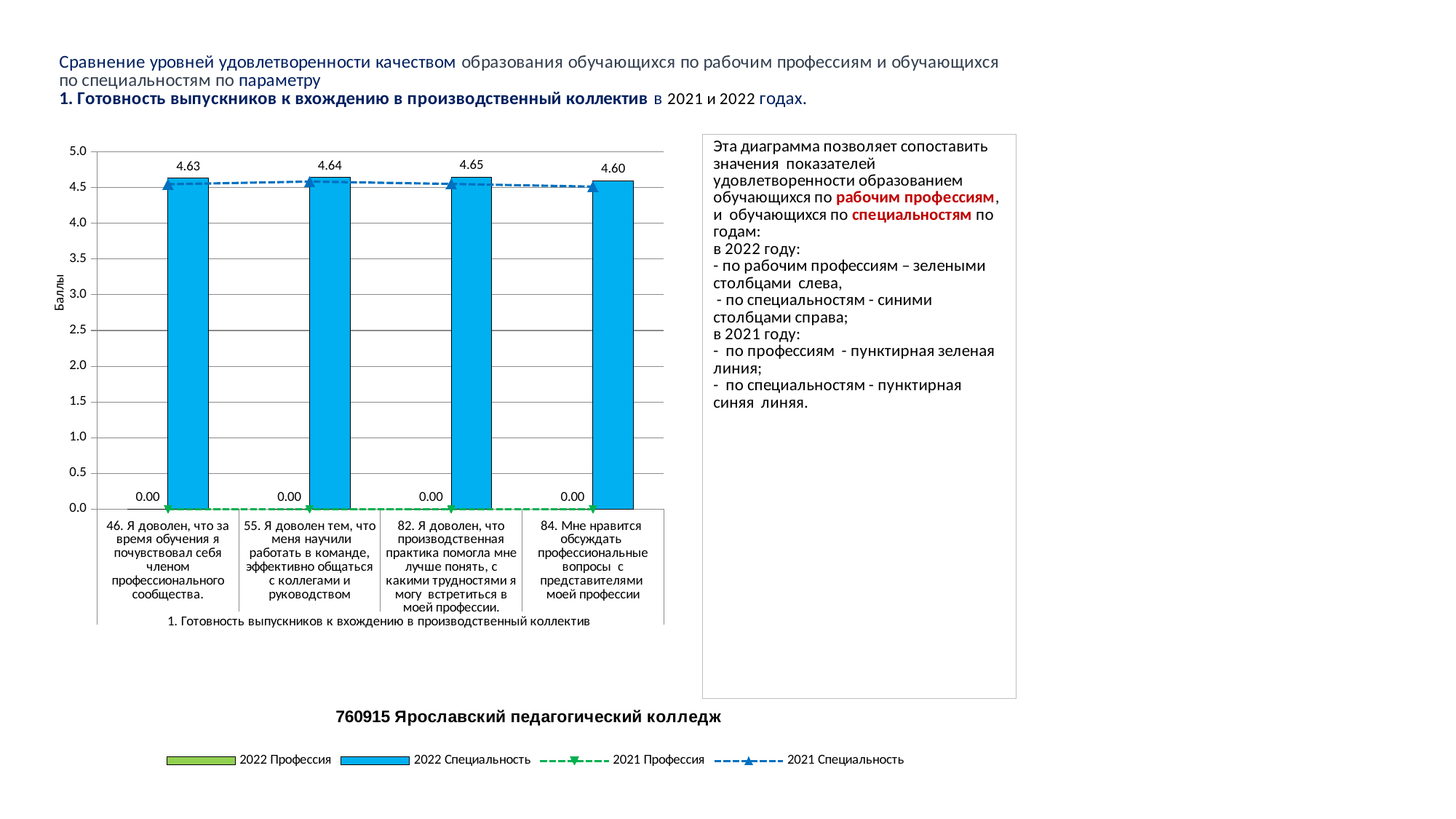
What is the value of the 2022 Специальность bar for item 46 (Я доволен, что за время обучения я почувствовал себя членом профессионального сообщества)? 4.63 Which item has the lowest 2022 Специальность value? 84. Мне нравится обсуждать профессиональные вопросы с представителями моей профессии What type of chart is used to show the 2022 values? Bar chart What is the value of the 2022 Специальность bar for item 55 (Я доволен тем, что меня научили работать в команде)? 4.64 How many series does the chart legend list? 4 What is the value of the 2022 Специальность bar for item 84 (Мне нравится обсуждать профессиональные вопросы)? 4.60 Which item has the highest 2022 Специальность value? 82. Я доволен, что производственная практика помогла мне лучше понять, с какими трудностями я могу встретиться в моей профессии. How many items (categories) are shown on the x axis of the chart? 4 What is the difference between the 2022 Специальность values for item 82 and item 84? 0.05 What is the label of the vertical axis of the chart? Баллы What is the value of the 2022 Специальность bar for item 82 (производственная практика помогла мне лучше понять)? 4.65 What value is shown for the 2022 Профессия series for item 46? 0.00